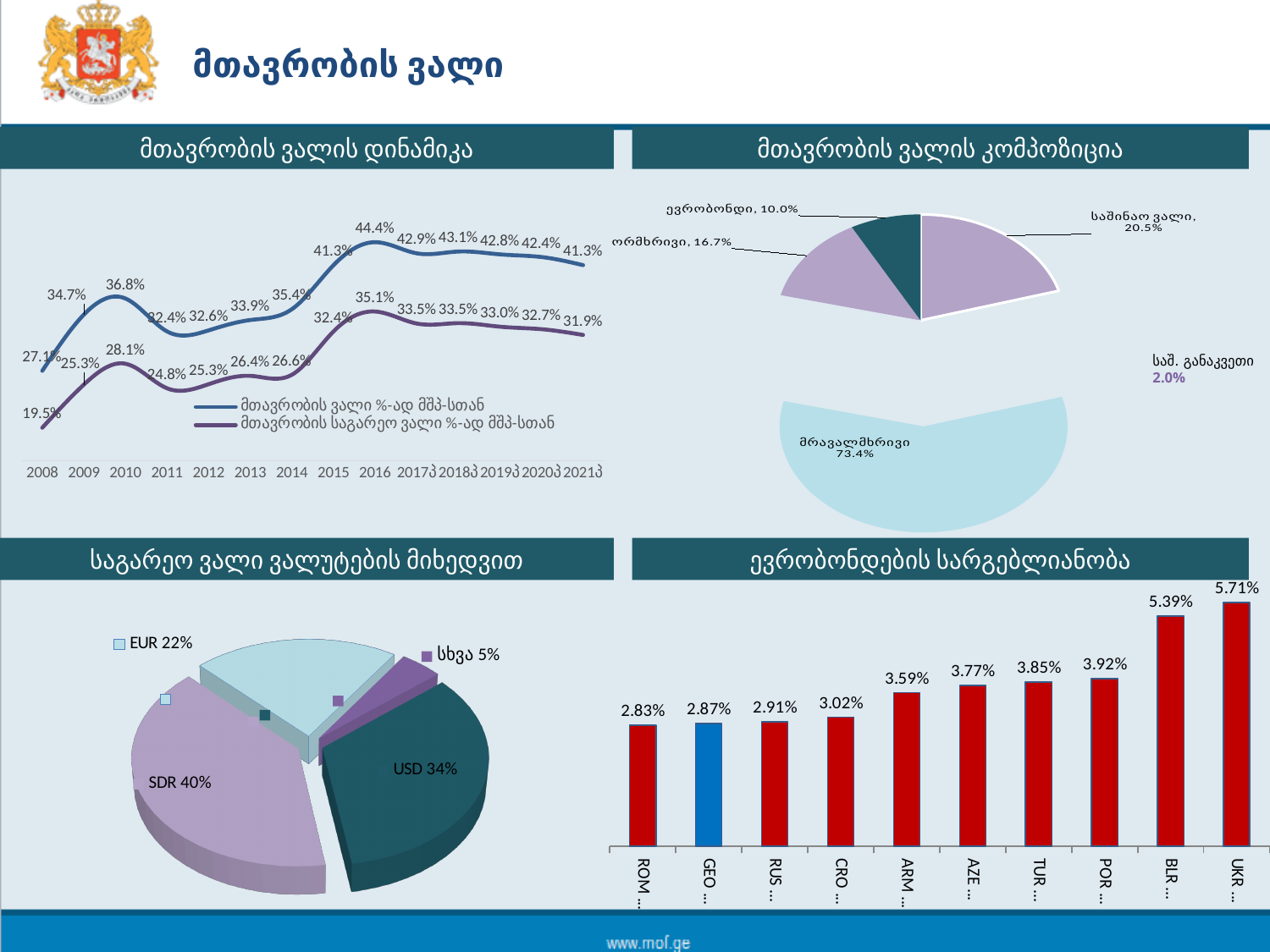
In the bottom-left pie chart, which currency has the smallest slice? სხვა In the top-left line chart, how many series does the legend list? 2 In the bottom-right bar chart, what is the difference between the values for BLR and GEO? 2.52% In the bottom-right bar chart, how many bars are shown? 10 In the bottom-right bar chart (ევრობონდების სარგებლიანობა), what is the value for UKR? 5.71% In the top-left line chart, what is the value of the purple series (მთავრობის საგარეო ვალი %-ად მშპ-სთან) in 2008? 19.5% In the top-left line chart (მთავრობის ვალის დინამიკა), what is the value of the blue series (მთავრობის ვალი %-ად მშპ-სთან) in 2016? 44.4% In the bottom-right bar chart, which country has the lowest value? ROM In the top-left line chart, does the blue series rise or fall from 2016 to 2021? fall In the bottom-right bar chart, which bar is coloured blue rather than red? GEO In the top-right pie chart (მთავრობის ვალის კომპოზიცია), what is the share of მრავალმხრივი? 73.4% In the bottom-left pie chart (საგარეო ვალი ვალუტების მიხედვით), what share does SDR have? 40%